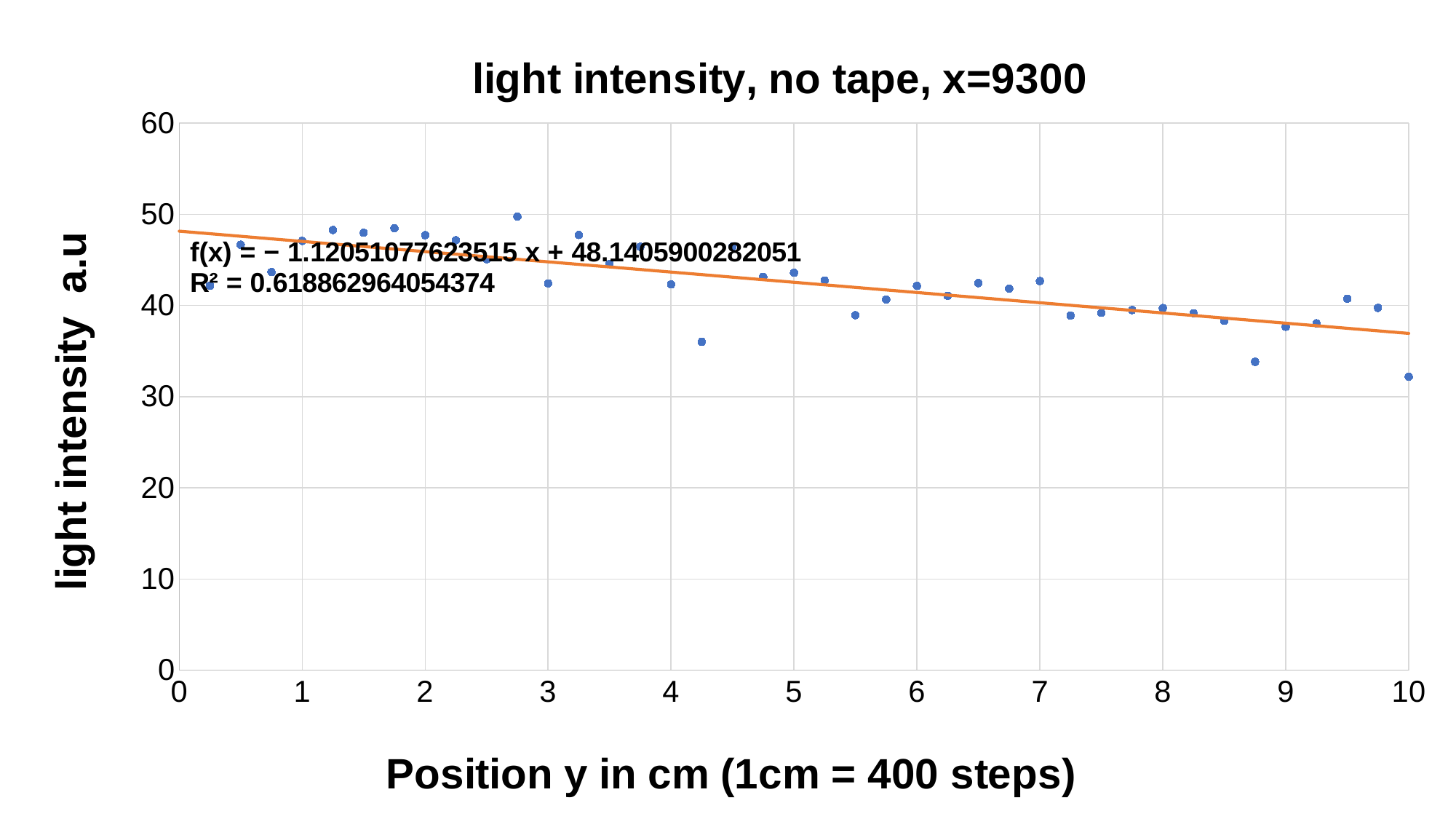
Which has the higher light intensity, position 1.25 or position 8.75? position 1.25 What is the slope of the fitted line f(x) printed on the chart? − 1.12051077623515 What is the intercept of the fitted line f(x) printed on the chart? 48.1405900282051 What R² value is printed on the chart? 0.618862964054374 Is the light intensity value at position 4.25 greater or less than 40? less Is the light intensity value at position 10 greater or less than 40? less Is the light intensity value at position 2.75 greater or less than 45? greater At which position y is the light intensity highest? 2.75 What is the label of the x axis? Position y in cm (1cm = 400 steps) What kind of chart is shown on the slide? scatter chart Do the light intensity values generally rise or fall as position y increases? fall What is the title of the chart? light intensity, no tape, x=9300